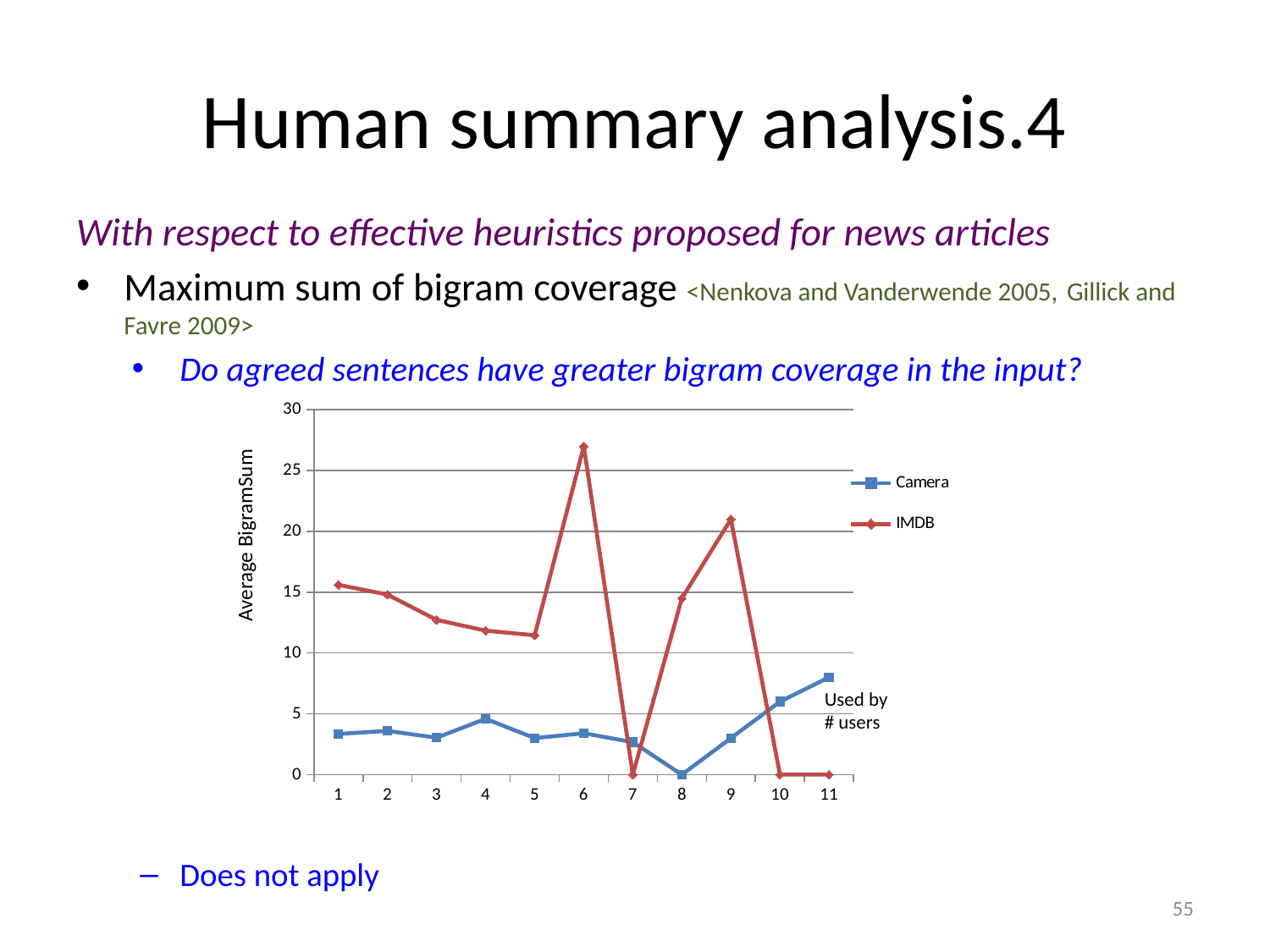
At which x value does the IMDB series reach its highest point? 6 What is the y-axis label of the chart? Average BigramSum How many series does the chart legend list? 2 Which series has the larger value at x = 11, Camera or IMDB? Camera Is the IMDB value at x = 6 greater or less than 25? greater Which series has the larger value at x = 9, Camera or IMDB? IMDB Does the Camera series rise or fall from x = 8 to x = 11? rise Which series is drawn in red on the chart? IMDB How many points are on the x axis of the chart? 11 What kind of chart is shown on the slide? line chart